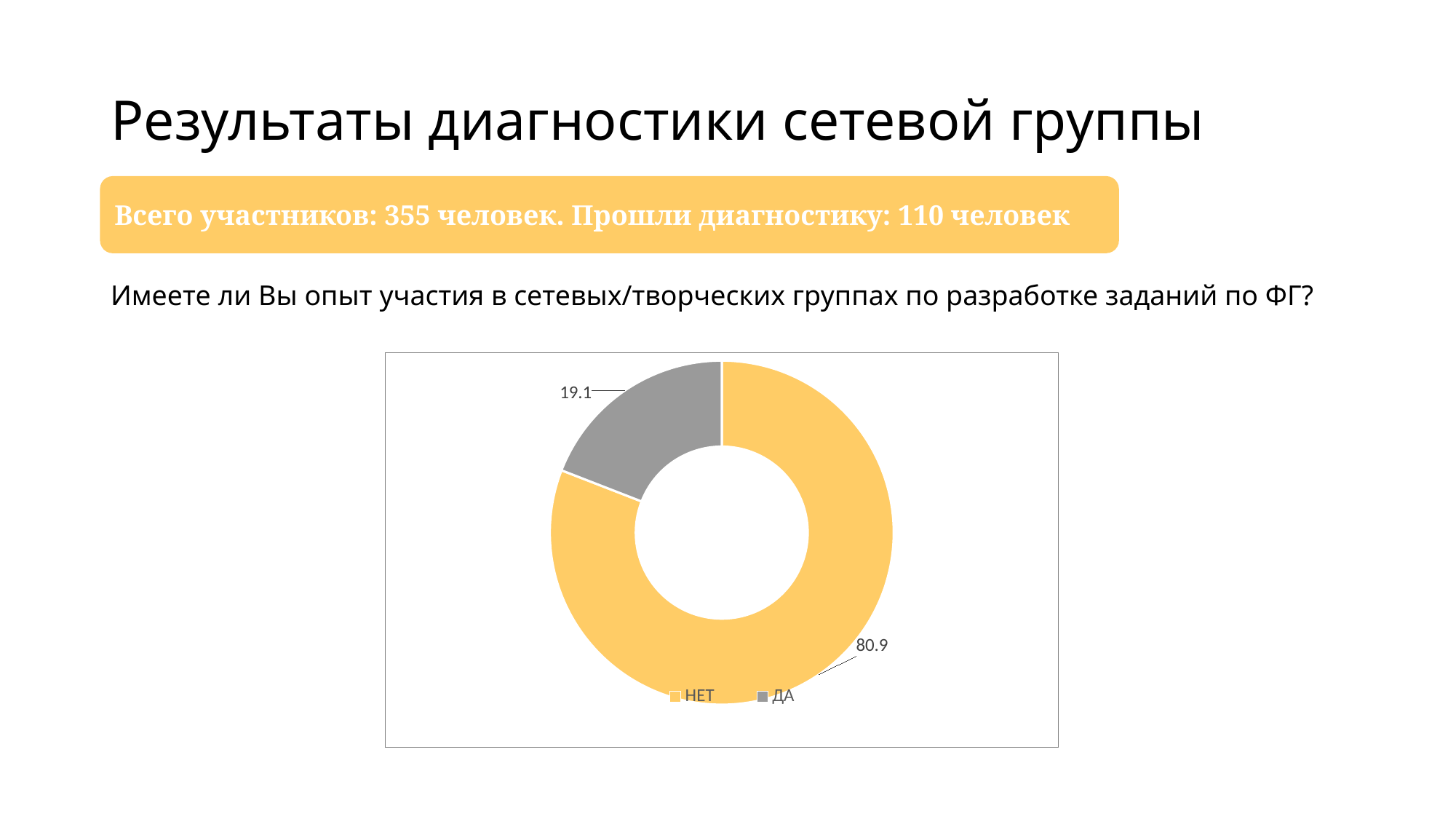
How many entries does the legend list? 2 What colour is the ДА segment? Grey How many categories does the chart show? 2 What colour is the НЕТ segment? Yellow/orange What kind of chart is shown on the slide? Doughnut (pie) chart Which category has the smallest share of the chart? ДА What is the total of the two values shown on the chart? 100 What is the difference between the values for НЕТ and ДА? 61.8 What is the value for ДА? 19.1 Which is larger, the value for НЕТ or the value for ДА? НЕТ What is the value for НЕТ? 80.9 Which category has the largest share of the chart? НЕТ